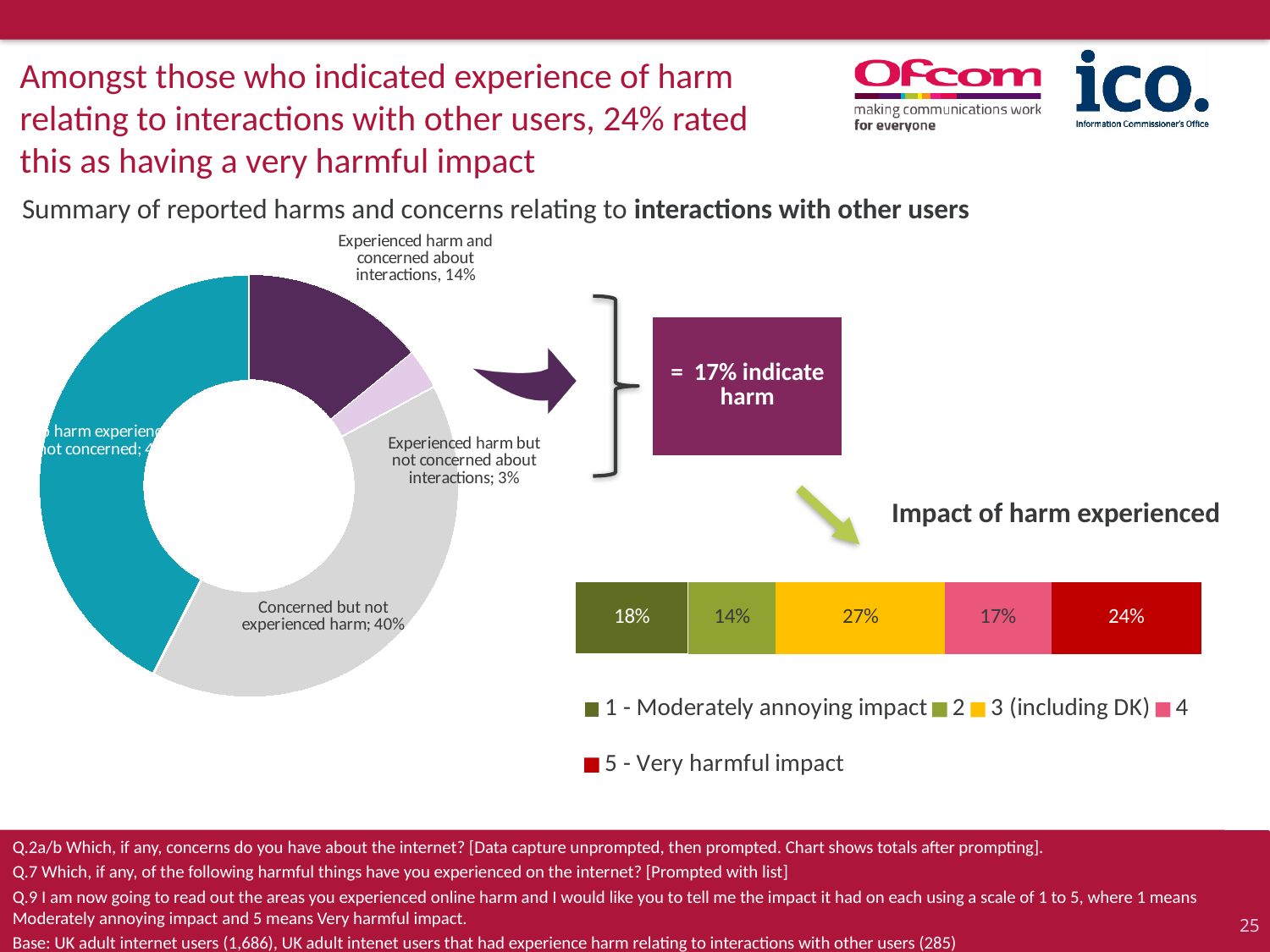
In the donut chart on the left, what percentage is shown for 'Concerned but not experienced harm'? 40% In the 'Impact of harm experienced' bar chart, what percentage is shown for '5 - Very harmful impact'? 24% In the 'Impact of harm experienced' bar chart, which rating has the lowest percentage? 2 In the donut chart on the left, how many percentage points larger is 'Concerned but not experienced harm' than 'Experienced harm and concerned about interactions'? 26 percentage points How many series does the legend of the 'Impact of harm experienced' bar chart list? 5 In the 'Impact of harm experienced' bar chart, which is larger: '1 - Moderately annoying impact' or '5 - Very harmful impact'? 5 - Very harmful impact What kind of chart is the 'Impact of harm experienced' chart? Stacked bar chart In the 'Impact of harm experienced' bar chart, which rating has the highest percentage? 3 (including DK) In the donut chart on the left, what percentage is shown for 'Experienced harm but not concerned about interactions'? 3% What kind of chart is the chart on the left of the slide? Pie chart (donut) In the donut chart on the left, what percentage is shown for 'Experienced harm and concerned about interactions'? 14% In the 'Impact of harm experienced' bar chart, what percentage is shown for '3 (including DK)'? 27%